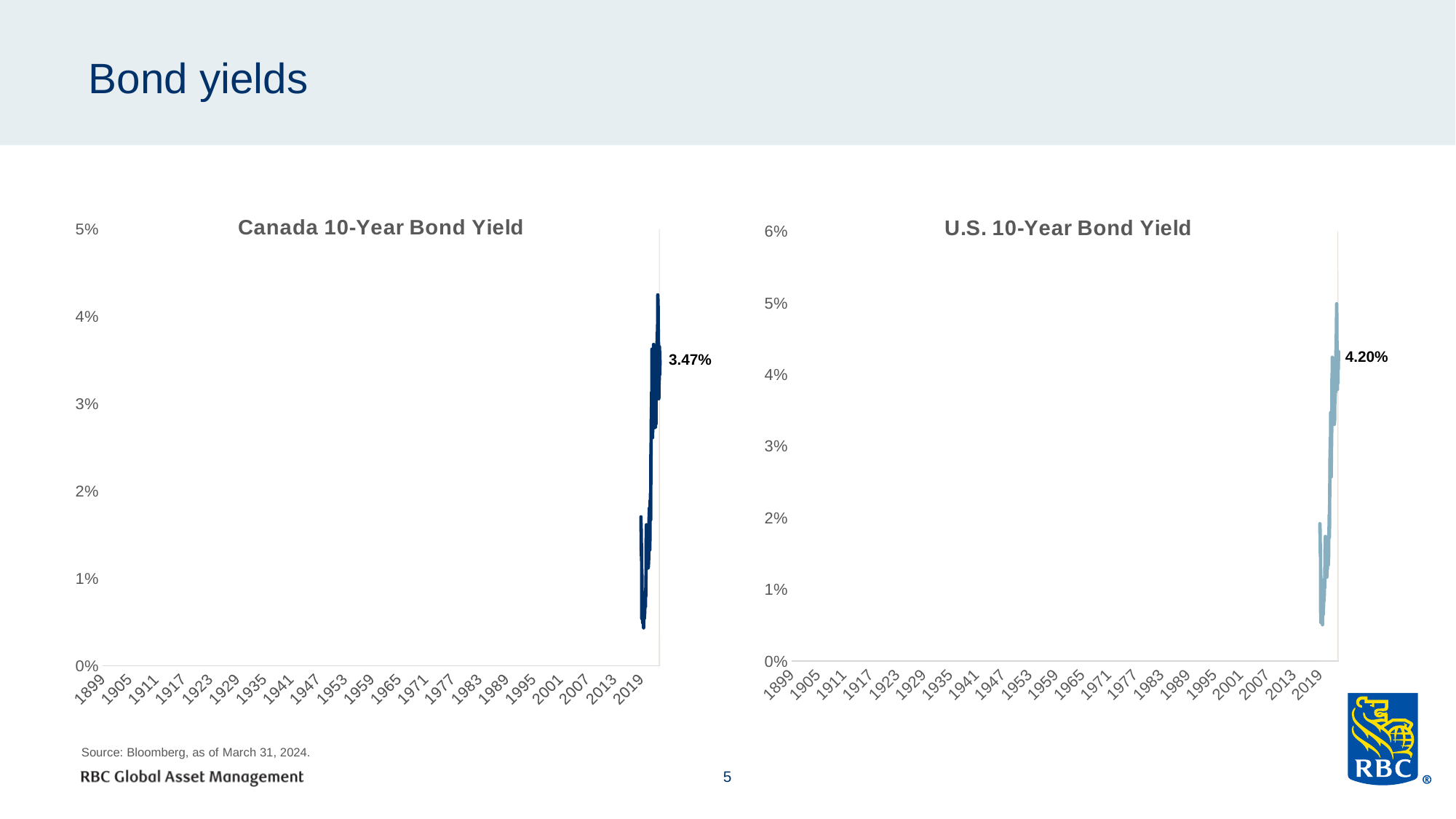
What kind of chart is the Canada 10-Year Bond Yield chart? Line chart On the U.S. 10-Year Bond Yield chart, is the highest point of the line greater or less than 4%? greater What is the difference between the labelled U.S. 10-Year Bond Yield (4.20%) and the labelled Canada 10-Year Bond Yield (3.47%)? 0.73 percentage points On the U.S. 10-Year Bond Yield chart, what is the latest value labelled on the line? 4.20% On the Canada 10-Year Bond Yield chart, is the labelled value of 3.47% greater or less than 3%? greater What kind of chart is the U.S. 10-Year Bond Yield chart? Line chart What is the highest value shown on the y axis of the U.S. 10-Year Bond Yield chart? 6% On the Canada 10-Year Bond Yield chart, what is the latest value labelled on the line? 3.47% What is the title of the chart on the left side of the slide? Canada 10-Year Bond Yield Comparing the labelled values, which is higher: the Canada 10-Year Bond Yield or the U.S. 10-Year Bond Yield? U.S. 10-Year Bond Yield On the U.S. 10-Year Bond Yield chart, is the labelled value of 4.20% greater or less than 5%? less